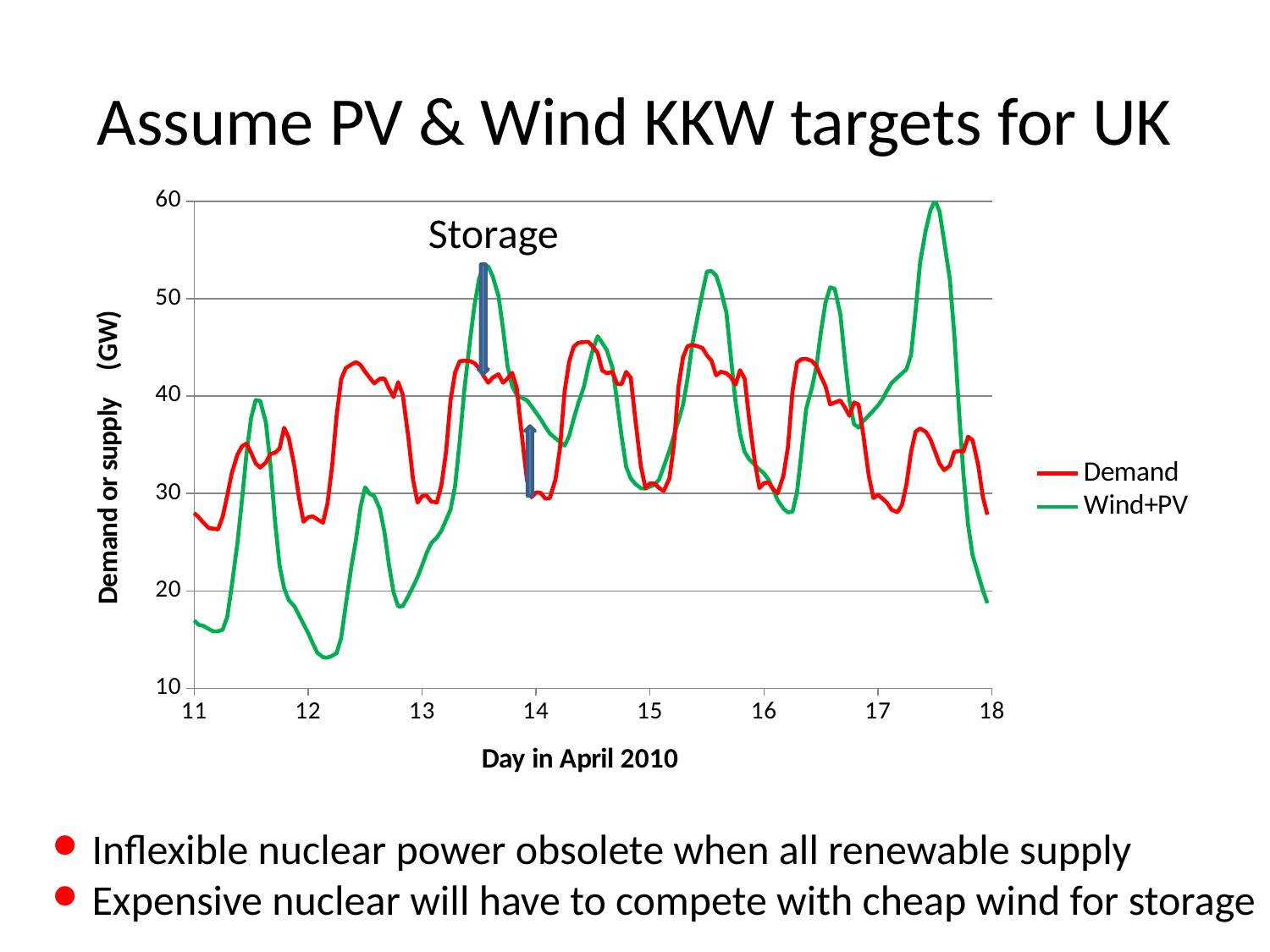
Which series drops to the lowest value anywhere on the chart? Wind+PV Which series reaches the highest value anywhere on the chart? Wind+PV Is the highest value of the Wind+PV series greater or less than 50? greater Is the Demand value at day 12 greater or less than 30? less At day 18, which series has the larger value, Demand or Wind+PV? Demand Is the highest value of the Demand series greater or less than 50? less How many series does the legend list? 2 What kind of chart is shown on the slide? Line chart At day 11, which series has the larger value, Demand or Wind+PV? Demand What is the title of the x axis? Day in April 2010 What are the two series named in the legend? Demand and Wind+PV